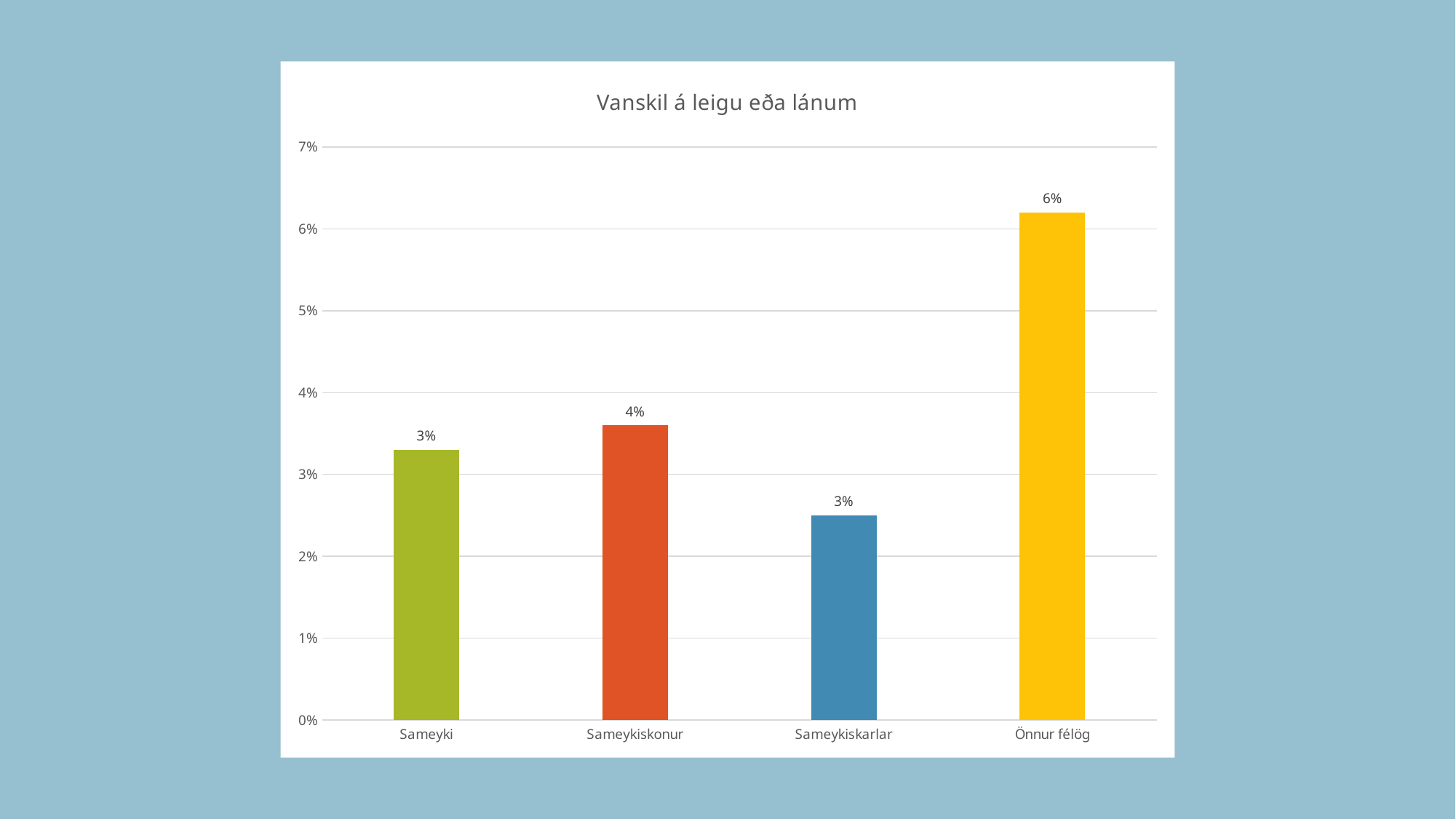
Which category has the lowest bar? Sameykiskarlar What colour is the bar for Önnur félög? yellow What is the value labelled for Sameykiskonur? 4% Is the bar for Sameykiskarlar greater or less than 3%? less Which is larger, the value for Önnur félög or the value for Sameykiskonur? Önnur félög What kind of chart is shown on the slide? bar chart What is the value labelled for Önnur félög? 6% Which category has the highest value? Önnur félög What is the title of the chart? Vanskil á leigu eða lánum How many categories are shown on the x axis? 4 What is the value labelled for Sameyki? 3% What is the difference between the labelled values for Önnur félög and Sameykiskonur? 2%